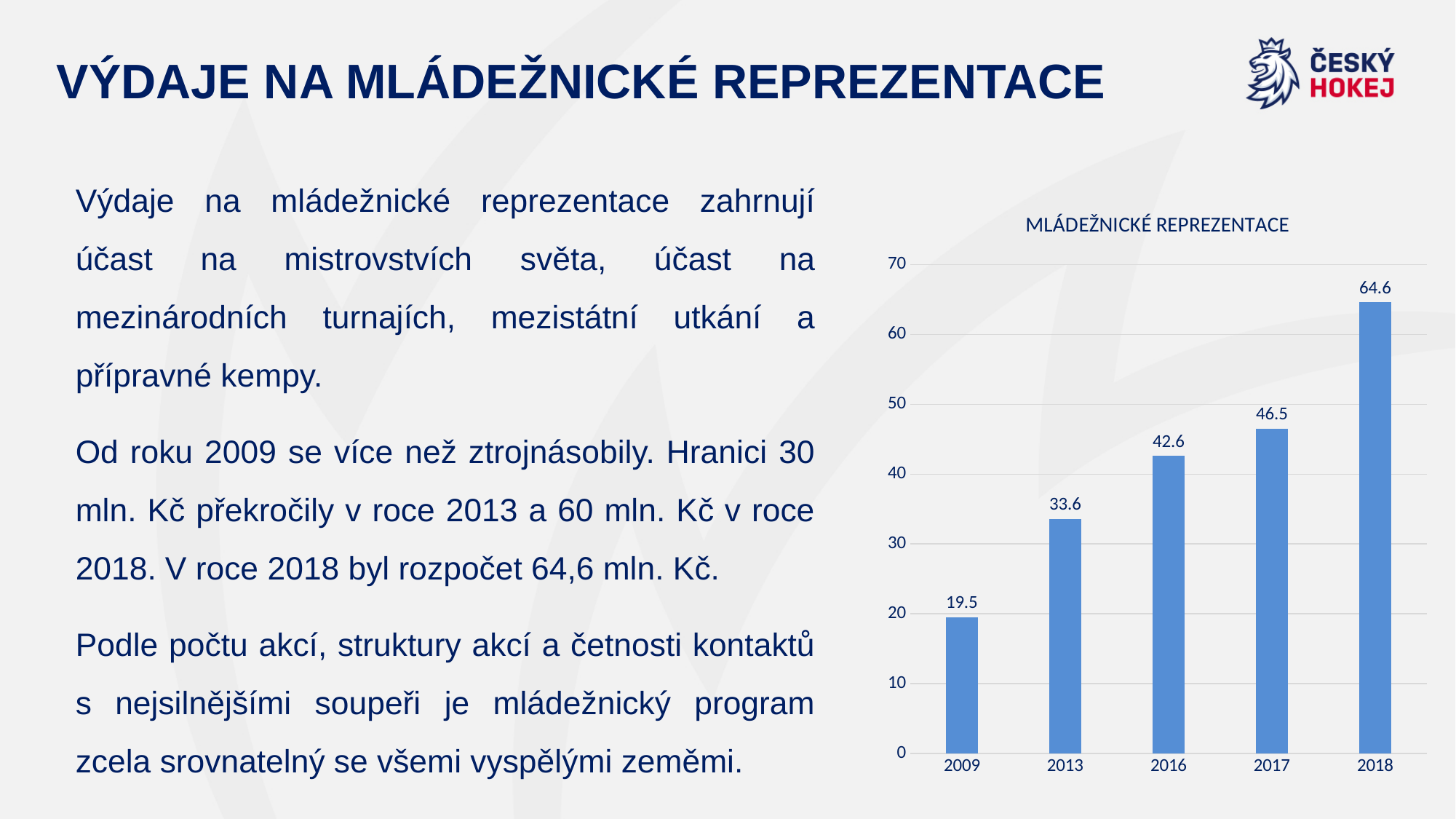
What kind of chart is shown? Bar chart What is the difference between the values for 2018 and 2009? 45.1 What is the value for 2018? 64.6 What is the value for 2009? 19.5 What is the value for 2013? 33.6 Which year has the highest value? 2018 What is the value for 2017? 46.5 Do the values rise or fall from 2009 to 2018? Rise Which is larger, the value for 2013 or the value for 2016? 2016 What is the value for 2016? 42.6 Which year has the lowest value? 2009 How many years are shown on the x axis? 5